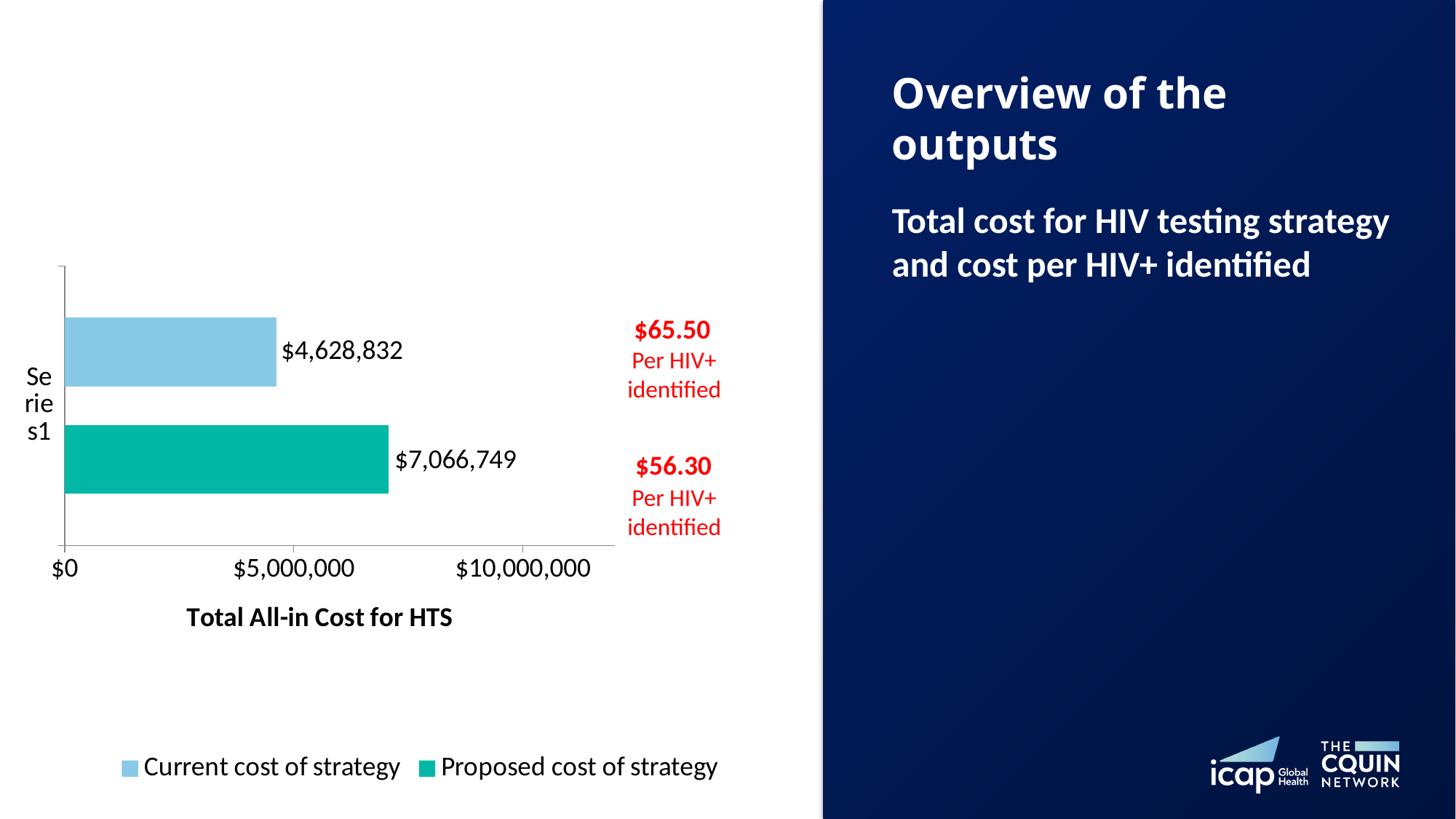
What is the cost per HIV+ identified annotated next to the proposed cost of strategy bar? $56.30 Which series has the higher total all-in cost for HTS, current or proposed cost of strategy? Proposed cost of strategy What is the current cost of strategy shown on the chart? $4,628,832 What is the title of the horizontal axis of the chart? Total All-in Cost for HTS What is the cost per HIV+ identified annotated next to the current cost of strategy bar? $65.50 Is the current cost of strategy greater or less than $5,000,000? less Is the proposed cost of strategy greater or less than $5,000,000? greater What kind of chart is shown on the slide? Bar chart How many series does the legend list? 2 Which series has the lower total all-in cost for HTS? Current cost of strategy What is the proposed cost of strategy shown on the chart? $7,066,749 What is the difference between the proposed cost of strategy and the current cost of strategy? $2,437,917